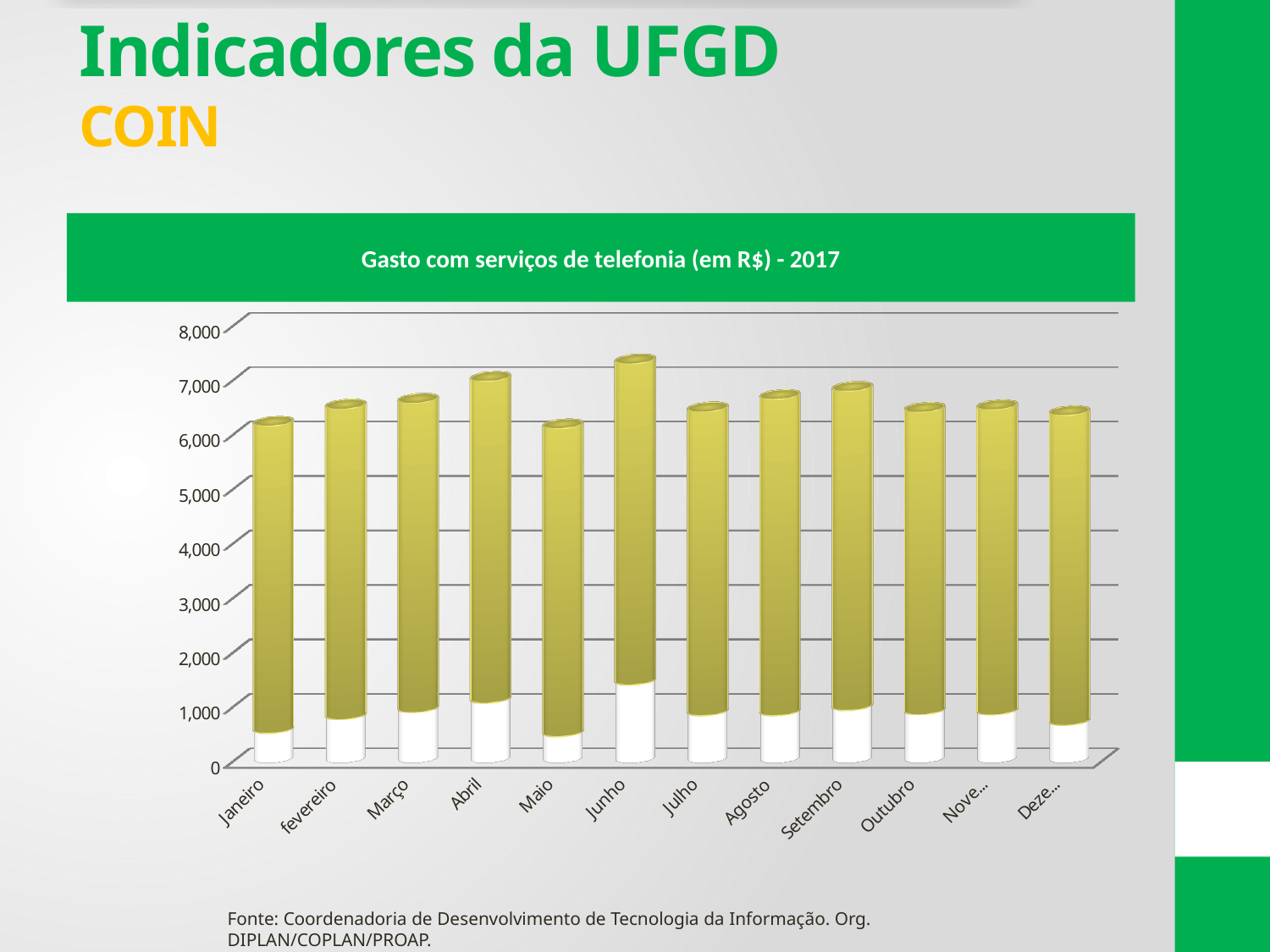
Is the value for Janeiro greater or less than 7,000? less What is the title of the chart? Gasto com serviços de telefonia (em R$) - 2017 Which is larger, the value for Abril or the value for Janeiro? Abril Is the value for Agosto greater or less than 7,000? less Is the value for Junho greater or less than 7,000? greater Which month has the highest telephone service expense? Junho How many months (categories) are plotted on the chart? 12 What kind of chart is shown on the slide? bar chart What is the highest value shown on the vertical axis of the chart? 8,000 Which is larger, the value for Junho or the value for Maio? Junho